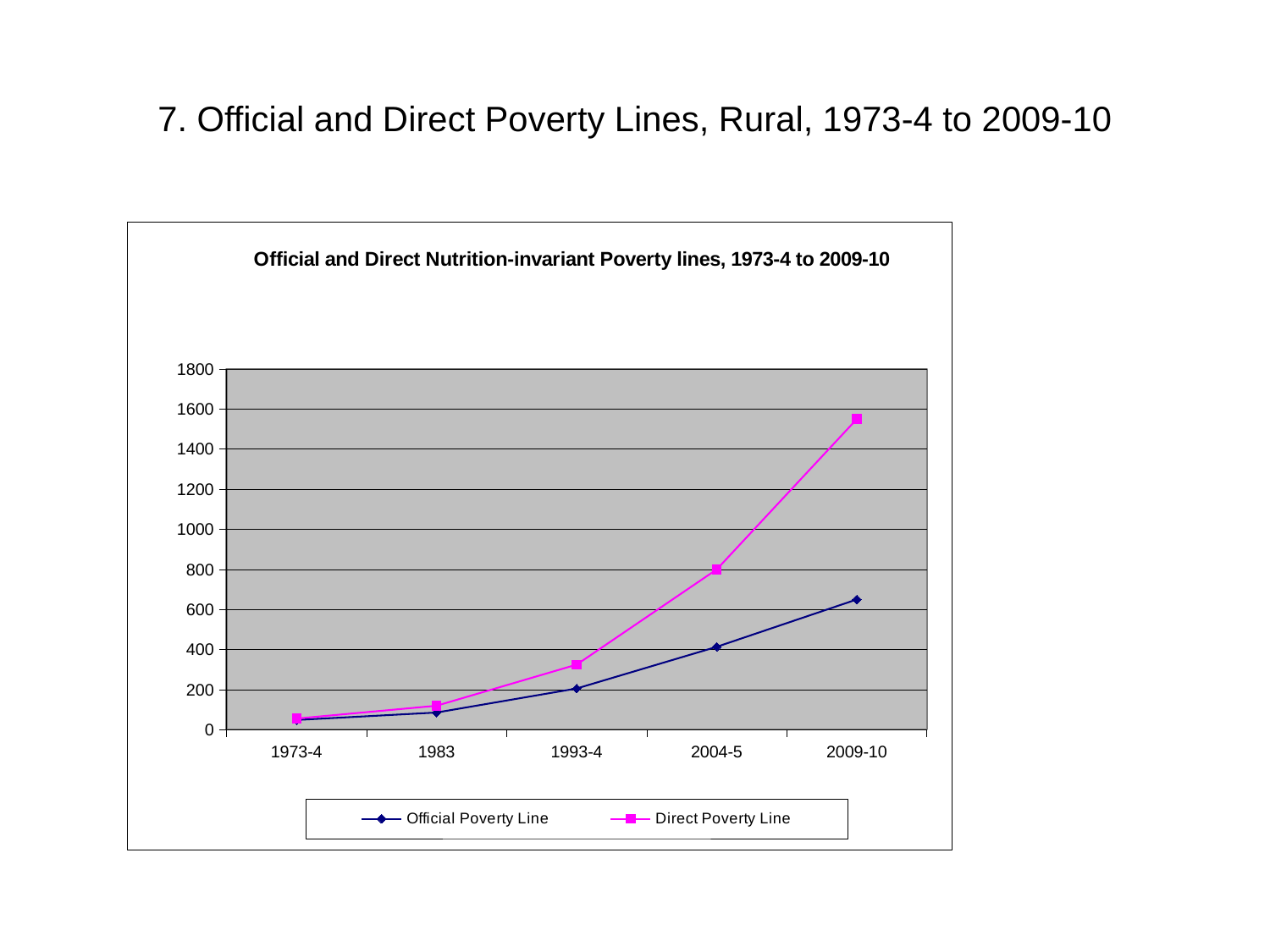
How many time points are plotted along the x axis? 5 Is the value of the Official Poverty Line in 2009-10 greater or less than 800? less Is the value of the Official Poverty Line in 2004-5 greater or less than 600? less How many series does the legend list? 2 In 2009-10, which is larger: the Official Poverty Line or the Direct Poverty Line? Direct Poverty Line What is the title printed inside the chart area? Official and Direct Nutrition-invariant Poverty lines, 1973-4 to 2009-10 What kind of chart is shown on the slide? line chart In which year is the Official Poverty Line lowest? 1973-4 In which year is the Direct Poverty Line highest? 2009-10 Is the value of the Direct Poverty Line in 2009-10 greater or less than 1400? greater Do the values of the Direct Poverty Line rise or fall from 1973-4 to 2009-10? rise